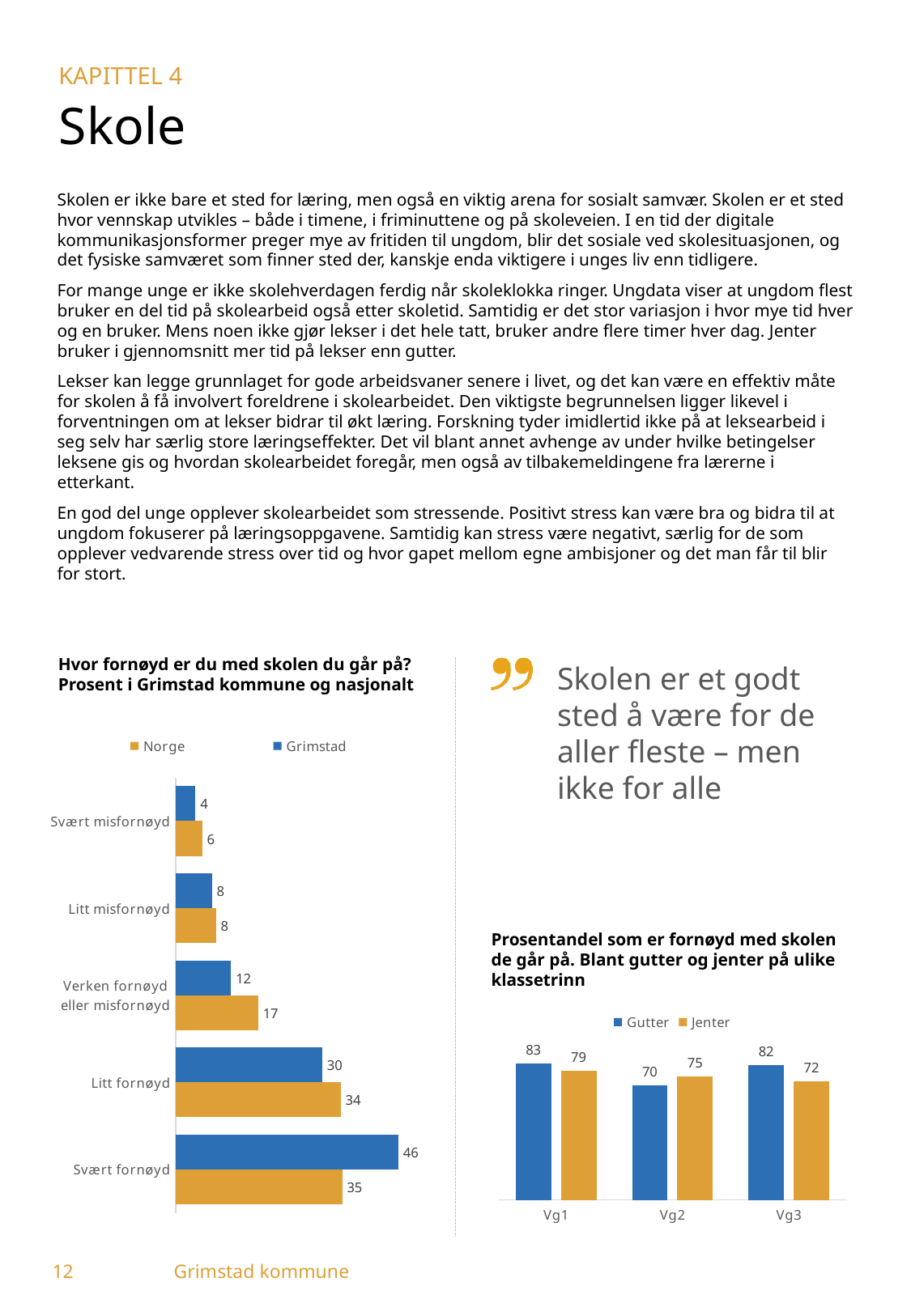
What kind of chart is 'Prosentandel som er fornøyd med skolen de går på'? bar chart In the chart 'Hvor fornøyd er du med skolen du går på?', which category has the highest Grimstad value? Svært fornøyd In the chart 'Hvor fornøyd er du med skolen du går på?', what is the Grimstad value for 'Svært fornøyd'? 46 In the chart 'Hvor fornøyd er du med skolen du går på?', which category has the lowest Norge value? Svært misfornøyd In the chart 'Hvor fornøyd er du med skolen du går på?', is the Norge value for 'Litt fornøyd' larger or smaller than the Grimstad value? larger In the chart 'Prosentandel som er fornøyd med skolen de går på', what is the Jenter value for Vg2? 75 In the chart 'Hvor fornøyd er du med skolen du går på?', how many series does the legend list? 2 In the chart 'Prosentandel som er fornøyd med skolen de går på', what is the difference between the Gutter and Jenter values for Vg3? 10 In the chart 'Hvor fornøyd er du med skolen du går på?', what is the Norge value for 'Verken fornøyd eller misfornøyd'? 17 In the chart 'Hvor fornøyd er du med skolen du går på?', how many categories are shown? 5 In the chart 'Hvor fornøyd er du med skolen du går på?', what is the difference between the Grimstad and Norge values for 'Svært fornøyd'? 11 In the chart 'Prosentandel som er fornøyd med skolen de går på', which klassetrinn has the highest Gutter value? Vg1